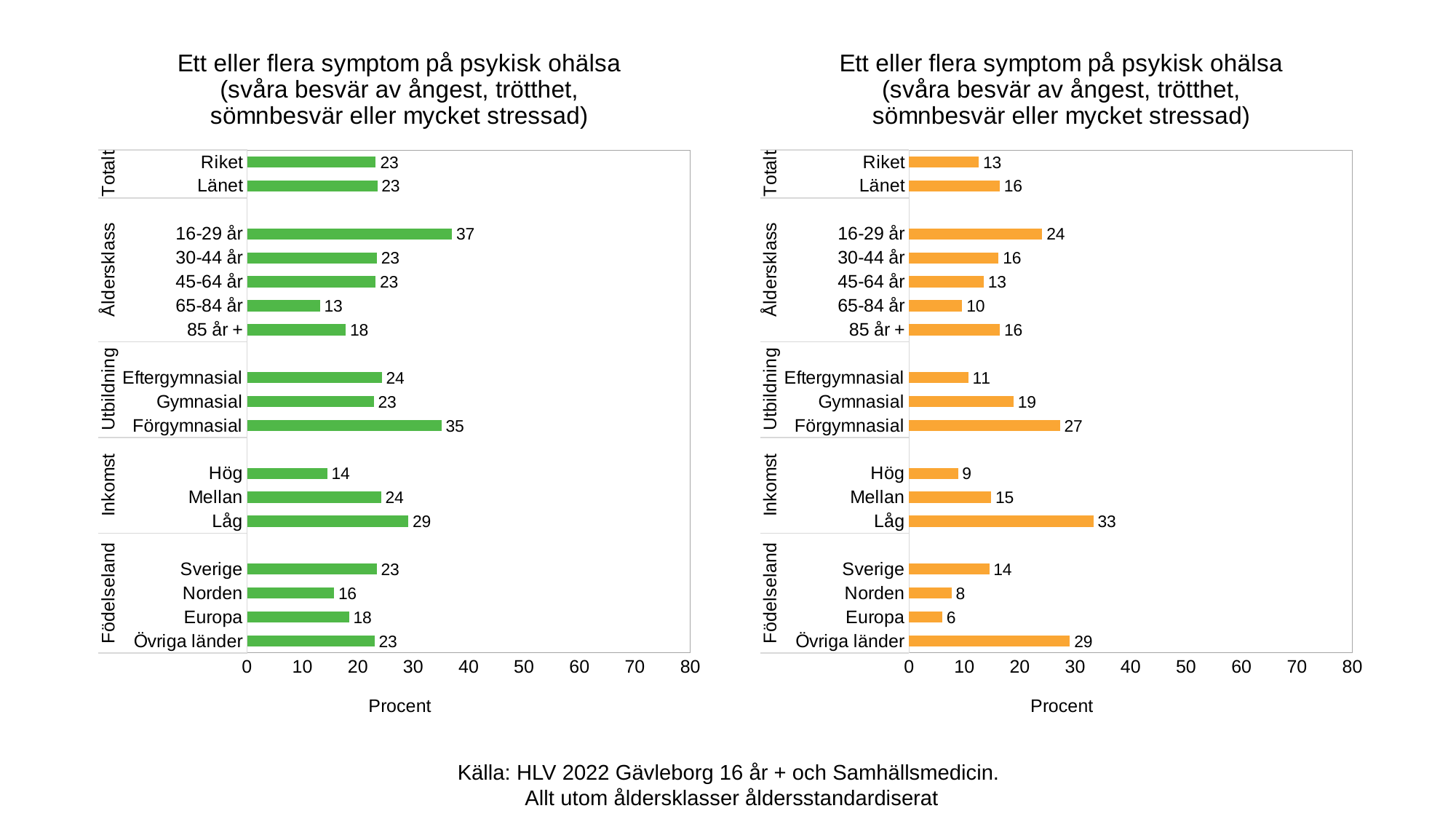
In the right chart, what is the difference between Länet and Riket? 3 In the left chart, which category has the lowest value? 65-84 år In the right chart, which category has the lowest value? Europa In the left chart, what is the value for 16-29 år? 37 What type of chart is the left chart? Bar chart In the right chart, which is larger, Förgymnasial or Gymnasial? Förgymnasial In the left chart, what is the difference between Förgymnasial and Eftergymnasial? 11 In the right chart, what is the value for Europa? 6 In the left chart, which category has the highest value? 16-29 år In the left chart, is the value for Låg greater or less than 20? greater How many categories are plotted in the right chart? 17 In the right chart, what is the value for Låg? 33